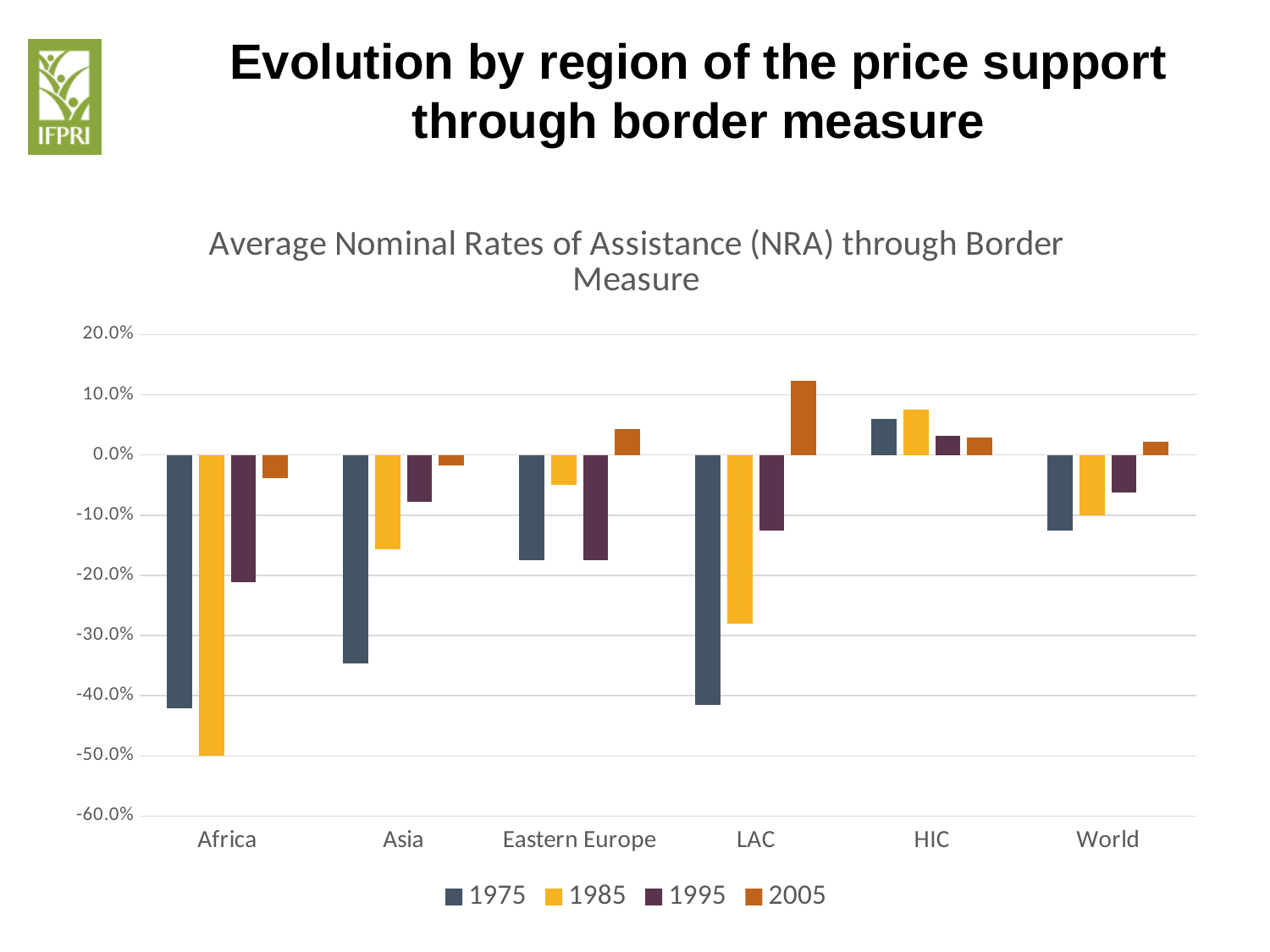
What is the title of the chart? Average Nominal Rates of Assistance (NRA) through Border Measure Which is larger, the 1975 value for Asia or the 1975 value for LAC? Asia Is the value for Africa in 1975 greater or less than -40.0%? less Which is larger, the 1985 value for HIC or the 1985 value for World? HIC Which region has the lowest value for the 1985 series? Africa How many series does the legend list? 4 Which region has the highest value for the 2005 series? LAC Is the value for LAC in 2005 greater or less than 10.0%? greater How many regions (categories) are shown on the x axis? 6 What kind of chart is shown on the slide? bar chart For Africa, do the values rise or fall from the 1975 series to the 2005 series? rise Is the value for Asia in 1985 greater or less than -20.0%? greater